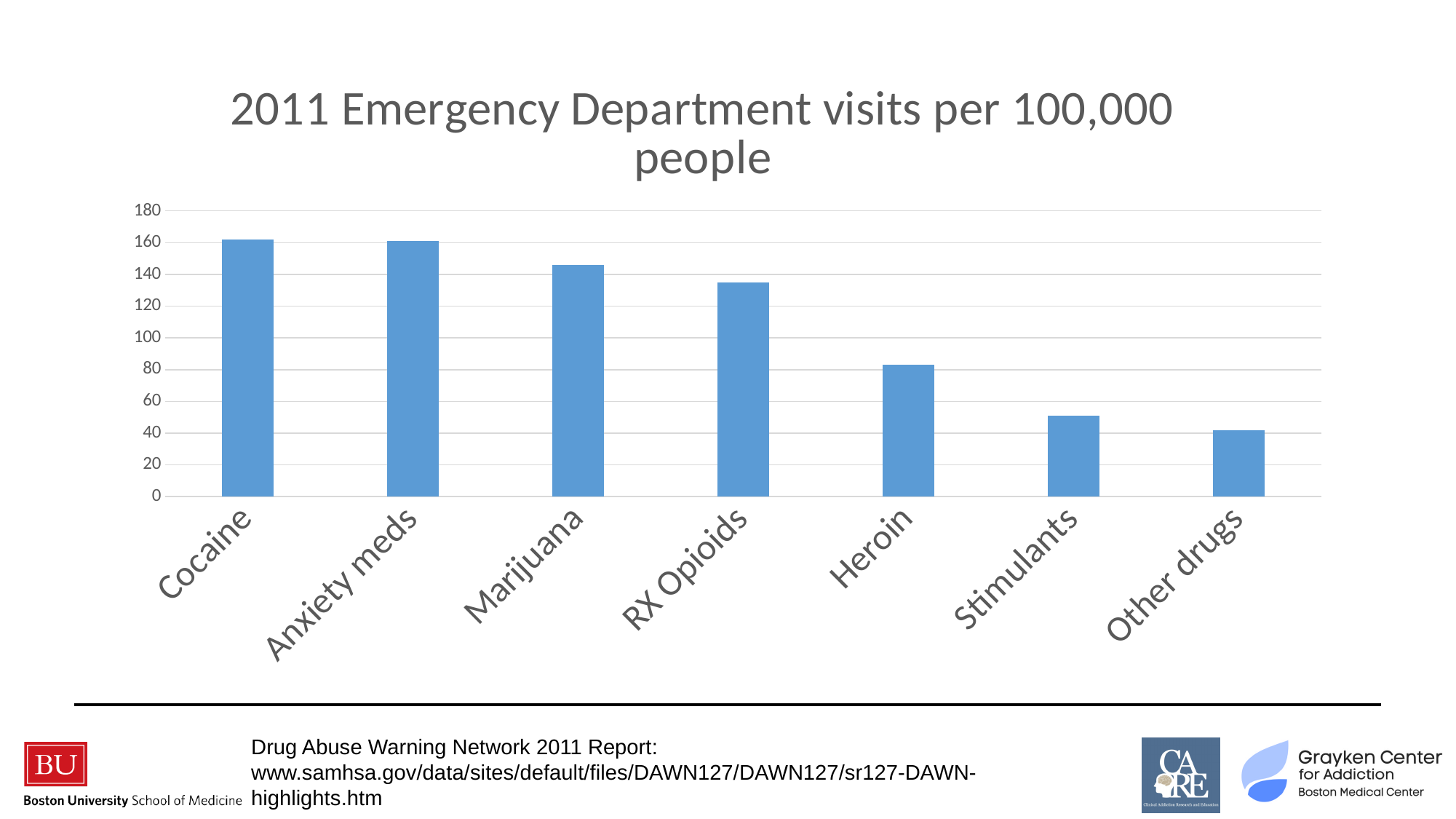
Is the value for Stimulants greater or less than 60? less Is the value for Other drugs greater or less than 60? less How many drug categories are shown on the x axis of the chart? 7 What kind of chart is shown on the slide? Bar chart Is the value for RX Opioids greater or less than 120? greater Which category has the lowest number of emergency department visits per 100,000 people? Other drugs Which has more emergency department visits per 100,000 people, Heroin or Stimulants? Heroin Which has more emergency department visits per 100,000 people, Marijuana or RX Opioids? Marijuana Do the bar values rise or fall moving from left to right along the x axis? Fall